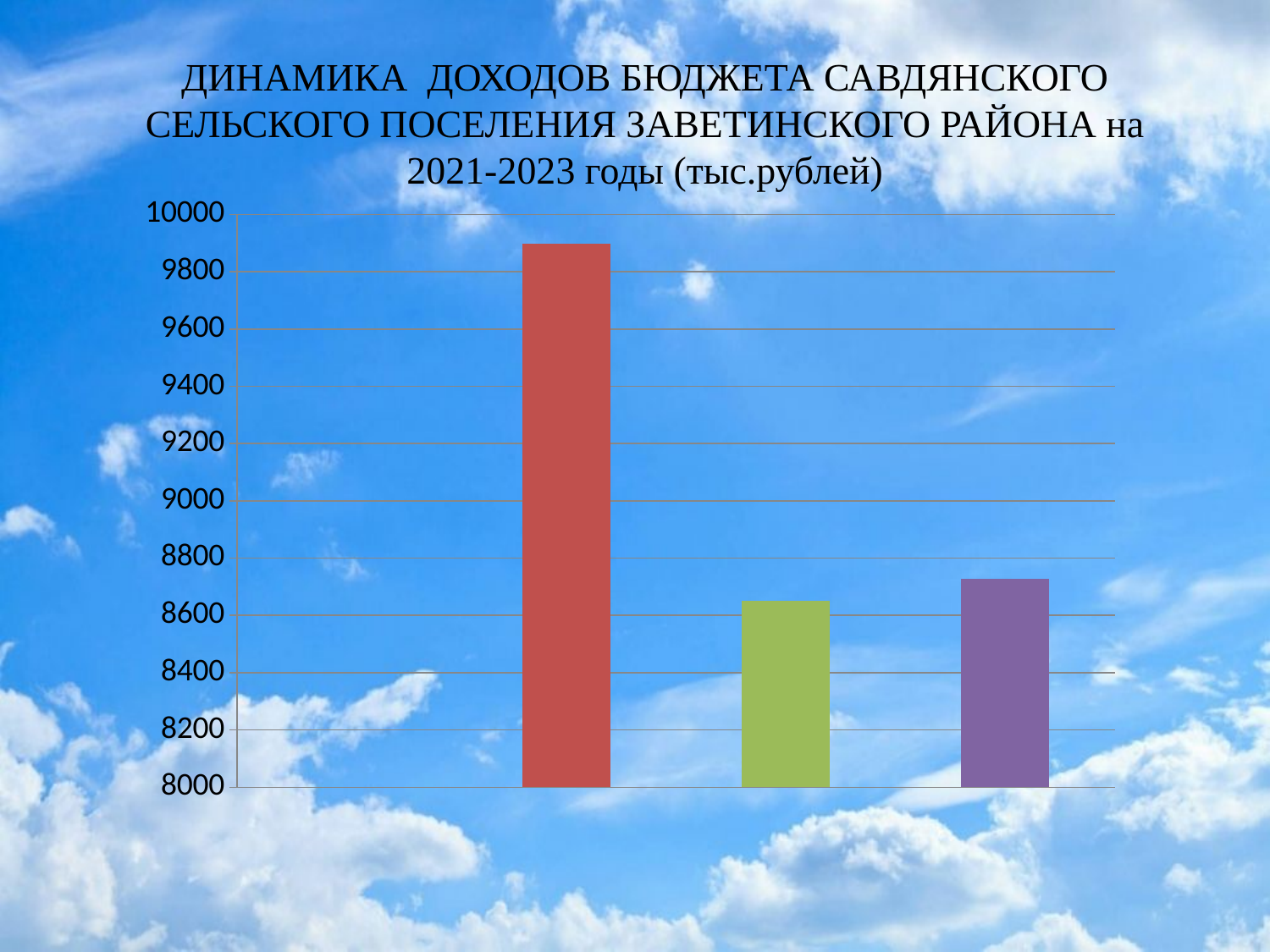
Is the value of the purple bar greater or less than 8600? greater What unit of measurement is stated in the chart title? тыс.рублей Which is larger, the green bar or the purple bar? the purple bar Is the value of the green bar greater or less than 8800? less How many bars are plotted in the chart? 3 Do the values rise or fall from the first bar to the second bar? fall What kind of chart is shown on the slide? bar chart Which bar is the shortest in the chart? the green bar (middle) Which bar is the tallest in the chart? the red bar (first from the left) Is the value of the red bar greater or less than 9800? greater Which is larger, the red bar or the purple bar? the red bar